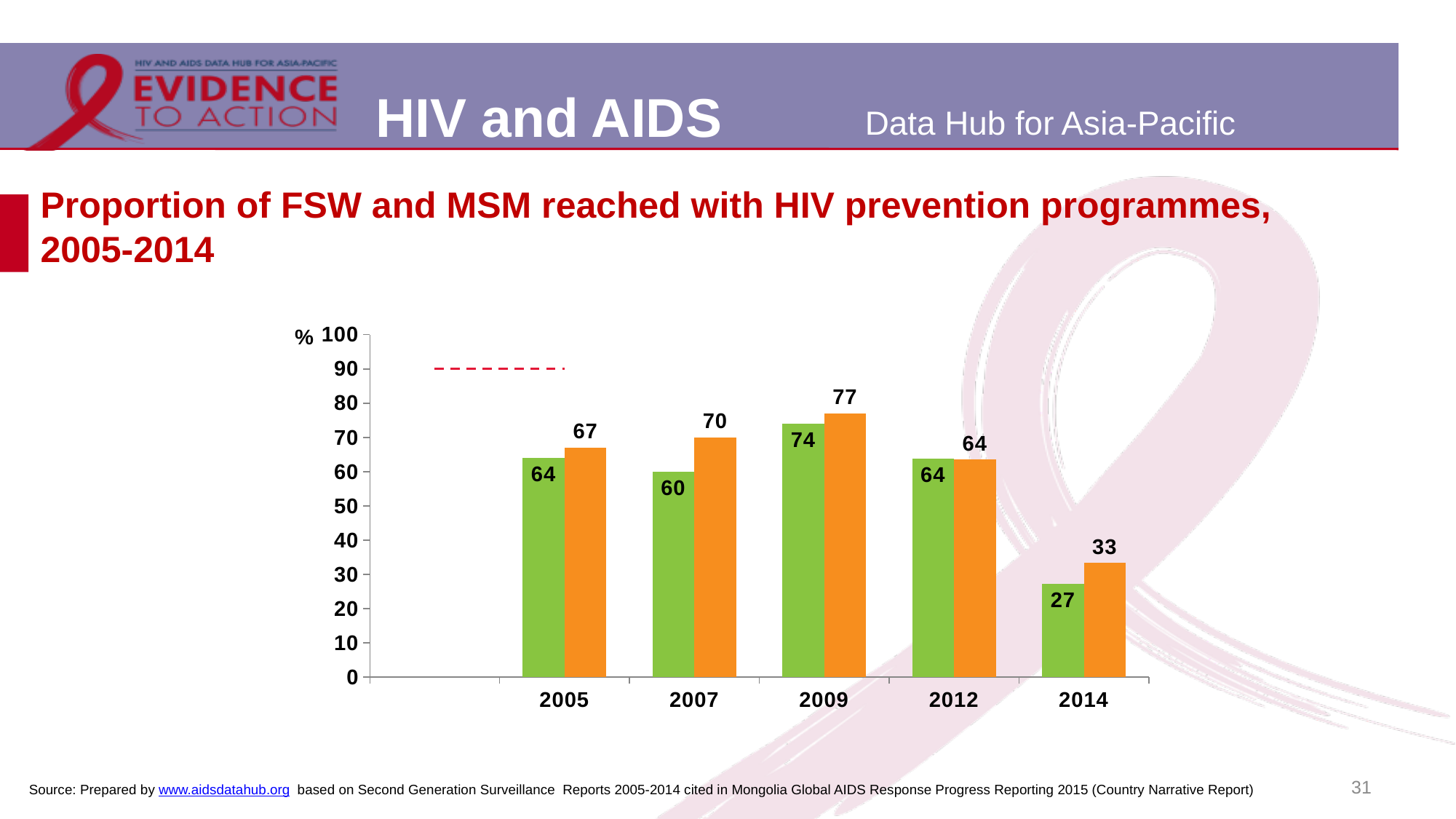
What kind of chart is shown on the slide? bar chart Do the green bar values rise or fall from 2012 to 2014? fall What is the value of the orange bar for 2014? 33 What is the difference between the orange bar and the green bar in 2007? 10 What is the value of the green bar for 2009? 74 In which year is the green bar lowest? 2014 What is the value of the orange bar for 2007? 70 In which year is the orange bar highest? 2009 Is the value of the orange bar for 2012 greater or less than 50? greater How many years are shown on the x axis? 5 What is the difference between the green bar values for 2009 and 2014? 47 Which is larger in 2014, the green bar or the orange bar? the orange bar